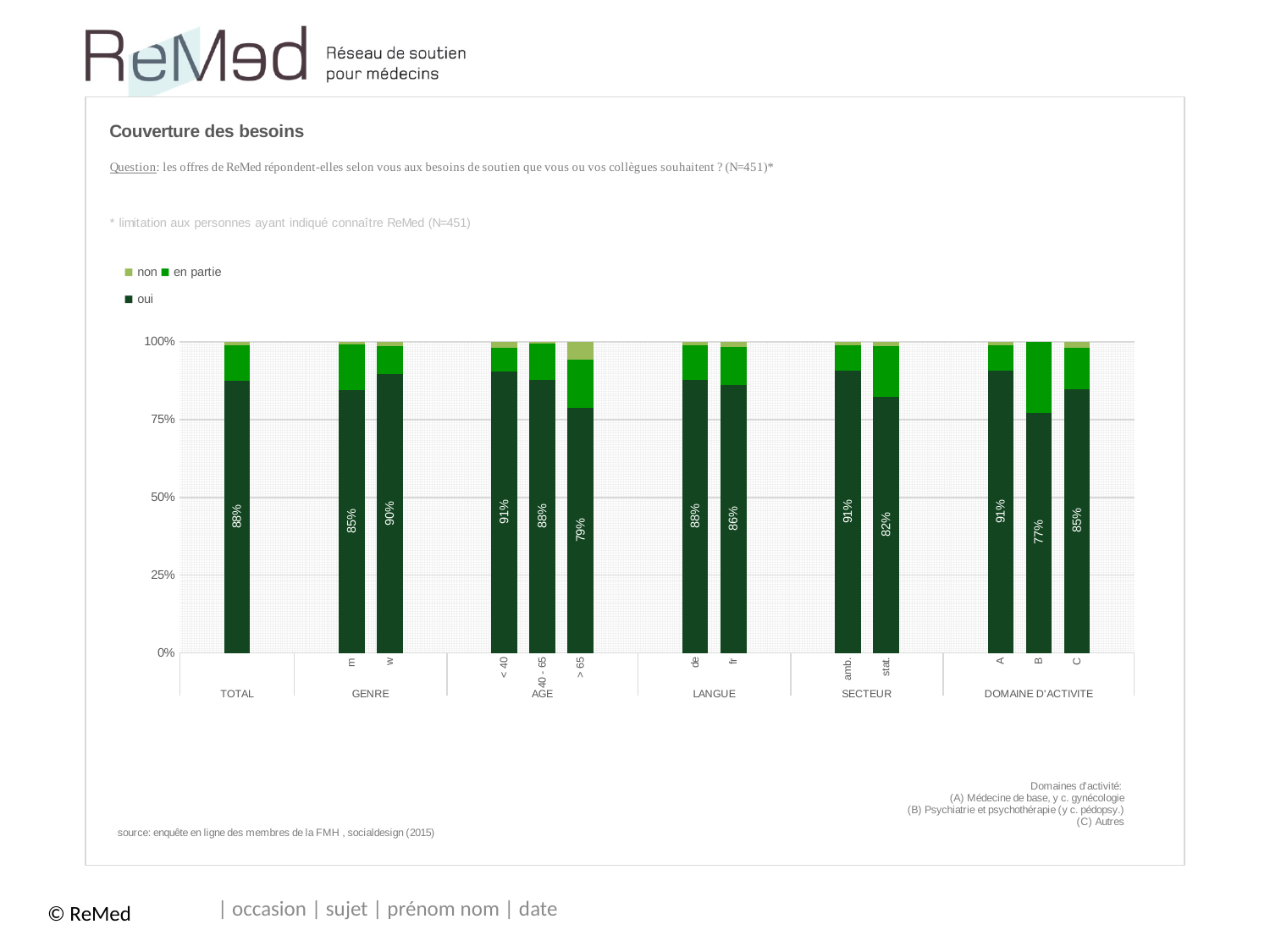
What is the 'oui' value for domain B in DOMAINE D'ACTIVITE? 77% Do the 'oui' values rise or fall across the AGE categories from '< 40' to '> 65'? fall Which category has the lowest 'oui' value? B (DOMAINE D'ACTIVITE) What is the difference between the 'oui' values for 'w' and 'm' in the GENRE group? 5% What is the 'oui' value for TOTAL? 88% How many series does the legend list? 3 What kind of chart is shown on the slide? Stacked bar chart Which has a larger 'oui' value, 'amb.' or 'stat.' in the SECTEUR group? amb. Is the 'oui' value for 'fr' greater or less than 75%? greater What is the title of the chart? Couverture des besoins What is the 'oui' value for the '> 65' age group? 79% What is the 'oui' value for 'stat.' in the SECTEUR group? 82%